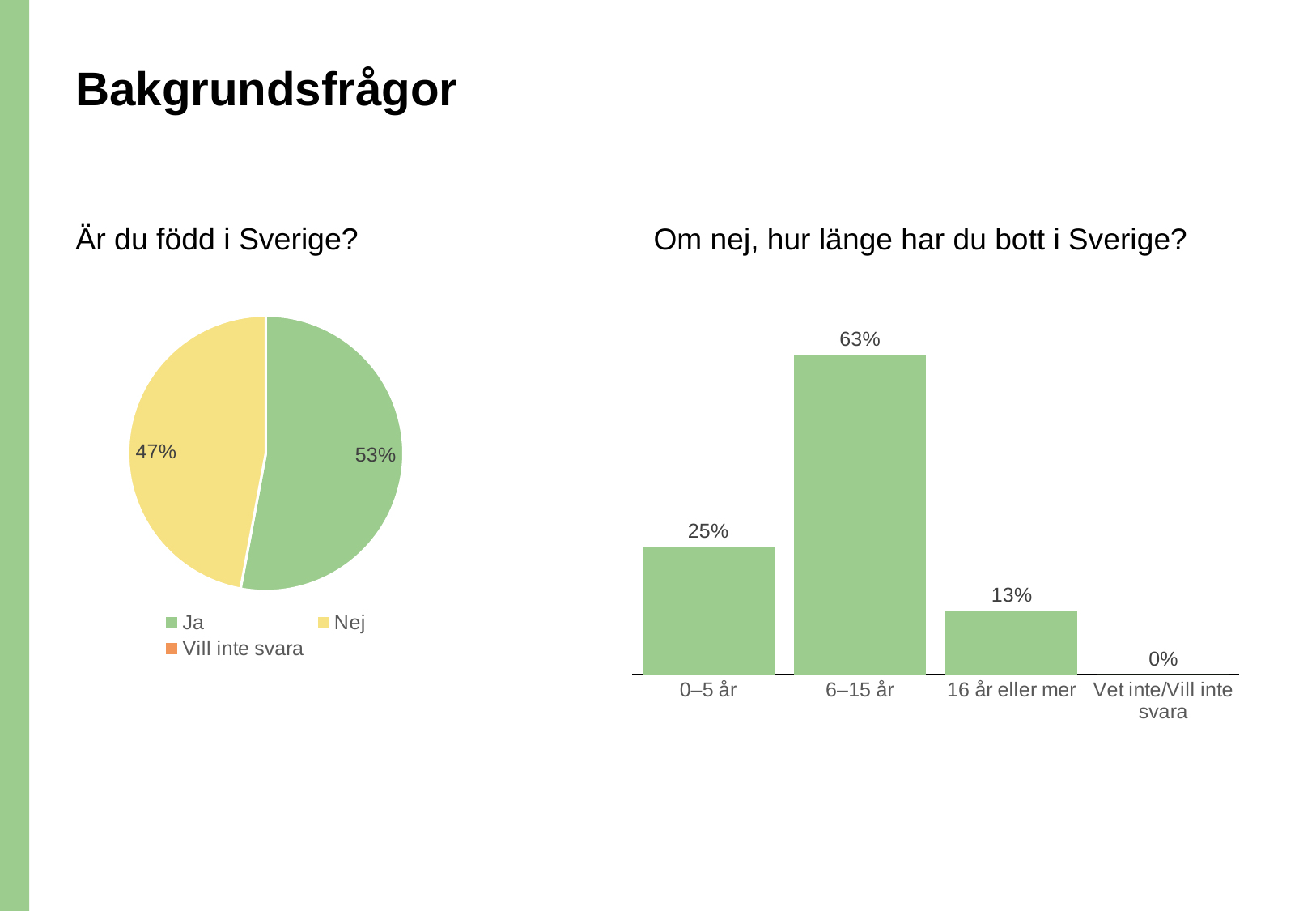
How many entries does the legend of the chart titled "Är du född i Sverige?" list? 3 In the chart titled "Om nej, hur länge har du bott i Sverige?", which category has the highest value? 6–15 år In the chart titled "Är du född i Sverige?", what share of respondents answered "Ja"? 53% In the chart titled "Är du född i Sverige?", which answer has the larger share, "Ja" or "Nej"? Ja In the chart titled "Om nej, hur länge har du bott i Sverige?", which category has the lowest value? Vet inte/Vill inte svara In the chart titled "Om nej, hur länge har du bott i Sverige?", what is the difference between "6–15 år" and "0–5 år"? 38 percentage points How many categories are shown in the chart titled "Om nej, hur länge har du bott i Sverige?"? 4 What kind of chart is the one titled "Är du född i Sverige?"? Pie chart In the chart titled "Om nej, hur länge har du bott i Sverige?", what is the value for "6–15 år"? 63% In the chart titled "Är du född i Sverige?", what is the difference in percentage points between "Ja" and "Nej"? 6 percentage points In the chart titled "Är du född i Sverige?", what share of respondents answered "Nej"? 47% In the chart titled "Om nej, hur länge har du bott i Sverige?", what is the value for "16 år eller mer"? 13%